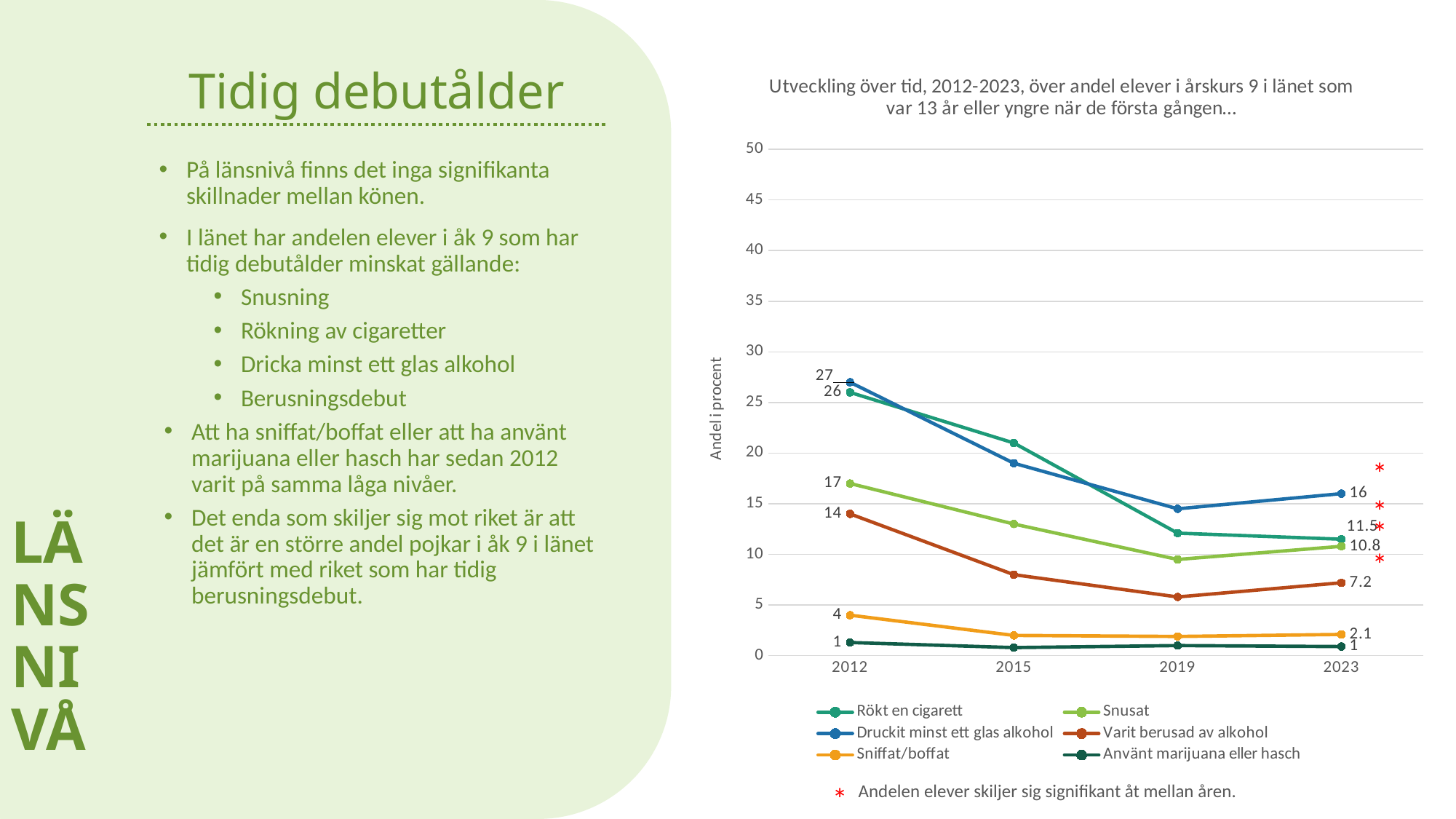
What kind of chart is shown on the slide? line chart What was the value for 'Varit berusad av alkohol' in 2023? 7.2 Which series had the highest value in 2023? Druckit minst ett glas alkohol Which series had the lowest value in 2012? Använt marijuana eller hasch What was the value for 'Rökt en cigarett' in 2023? 11.5 What was the value for 'Snusat' in 2012? 17 By how much did the value for 'Snusat' fall from 2012 to 2023? 6.2 Is the value for 'Rökt en cigarett' in 2015 greater or less than 20? greater How many years are plotted along the x axis? 4 What was the value for 'Druckit minst ett glas alkohol' in 2012? 27 How many series does the legend list? 6 Does the value for 'Sniffat/boffat' rise or fall from 2012 to 2023? fall